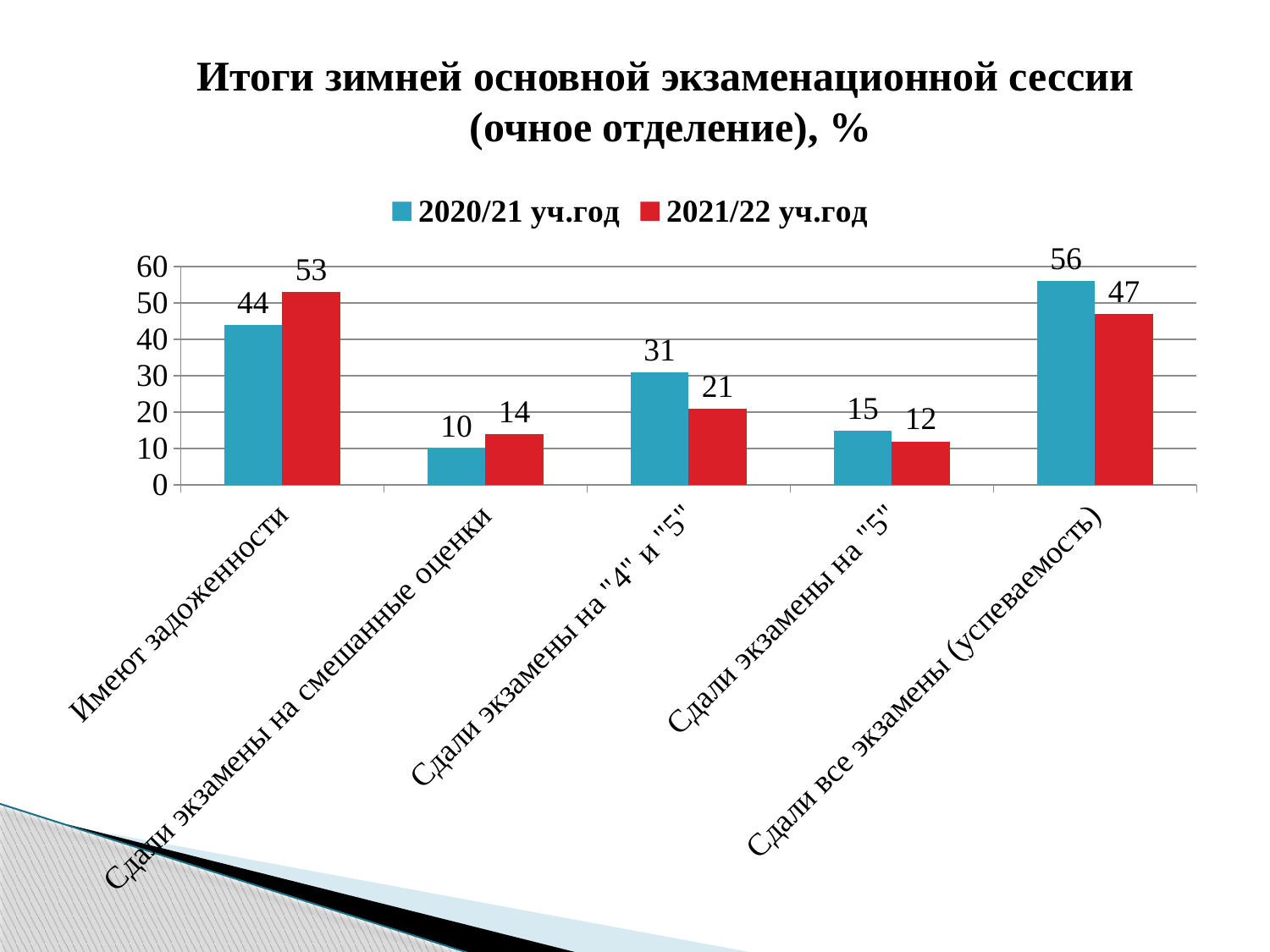
Which series has the larger value for "Сдали экзамены на смешанные оценки"? 2021/22 уч.год What is the value for "Имеют задолженности" in the 2021/22 уч.год series? 53 What is the value for "Сдали все экзамены (успеваемость)" in the 2021/22 уч.год series? 47 What is the value for "Сдали экзамены на "4" и "5"" in the 2020/21 уч.год series? 31 What is the difference between the 2021/22 уч.год and 2020/21 уч.год values for "Имеют задолженности"? 9 What is the difference between the 2020/21 уч.год and 2021/22 уч.год values for "Сдали все экзамены (успеваемость)"? 9 What kind of chart is shown on the slide? Bar chart Which category has the highest value in the 2020/21 уч.год series? Сдали все экзамены (успеваемость) How many series does the legend list? 2 What colour represents the 2021/22 уч.год series? Red How many categories are shown on the x axis? 5 Which category has the lowest value in the 2021/22 уч.год series? Сдали экзамены на "5"